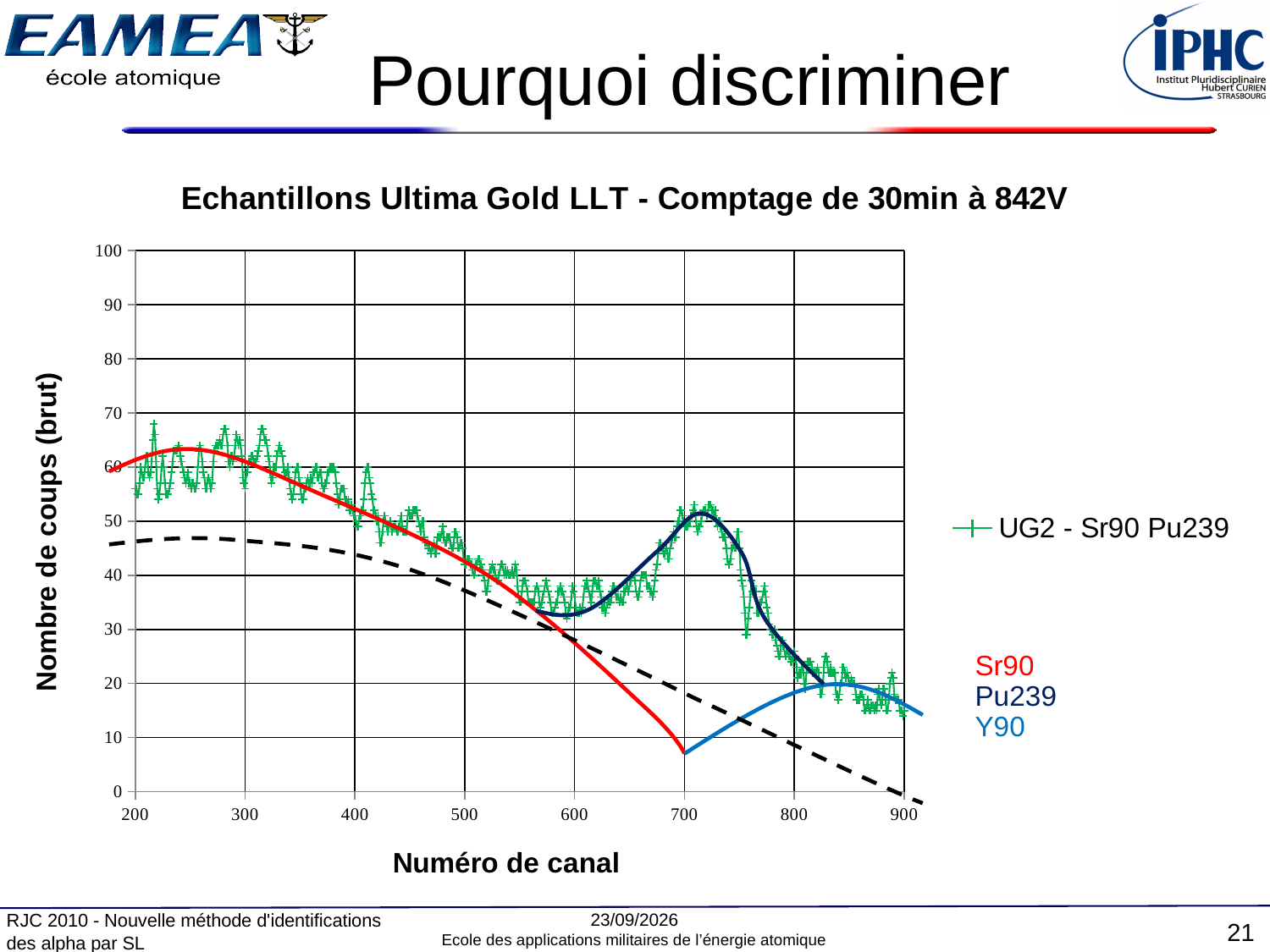
Which is larger for the UG2 - Sr90 Pu239 series: the value at channel 300 or the value at channel 600? channel 300 What is the highest value shown on the y axis? 100 Is the value of the UG2 - Sr90 Pu239 series at channel 700 greater or less than 40? greater What is the label of the x axis? Numéro de canal Is the value of the UG2 - Sr90 Pu239 series at channel 600 greater or less than 40? less Do the values of the UG2 - Sr90 Pu239 series rise or fall between channel 200 and channel 600? fall Is the value of the UG2 - Sr90 Pu239 series at channel 300 greater or less than 50? greater What kind of chart is shown on the slide? line chart Do the values of the UG2 - Sr90 Pu239 series rise or fall between channel 750 and channel 900? fall How many series does the chart legend list? 1 What is the title of the chart? Echantillons Ultima Gold LLT - Comptage de 30min à 842V